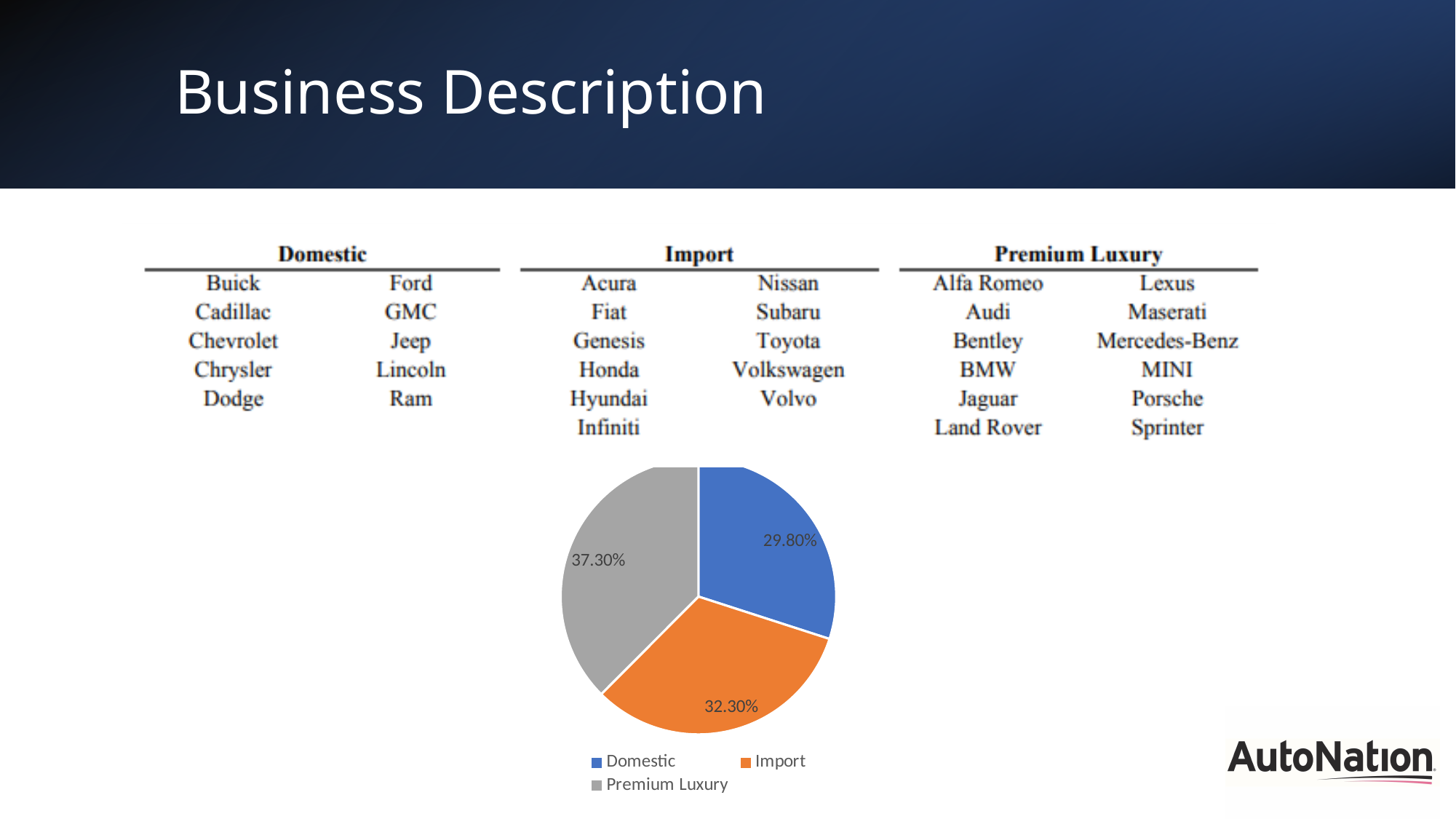
What kind of chart is shown on the slide? pie chart What colour is the Import segment in the pie chart? orange What is the difference in percentage points between the Premium Luxury and Domestic shares? 7.5 What is the difference in percentage points between the Import and Domestic shares? 2.5 Which is larger, the Import share or the Domestic share? Import Which segment has the smallest share of the pie? Domestic How many segments does the pie chart have? 3 What share of the pie does Import represent? 32.30% What share of the pie does Premium Luxury represent? 37.30% How many entries does the legend list? 3 Which segment has the largest share of the pie? Premium Luxury What share of the pie does Domestic represent? 29.80%